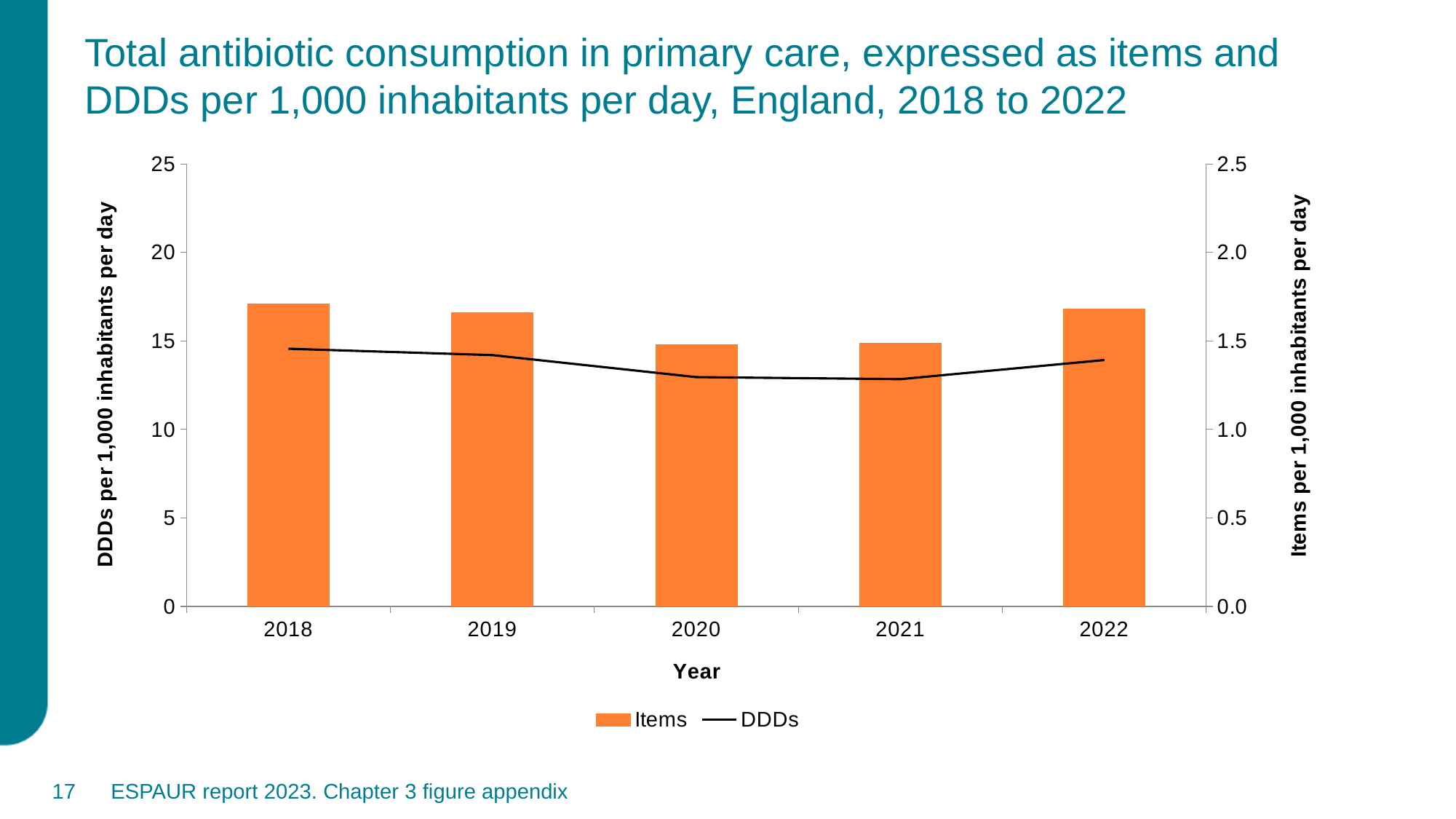
How many years are shown on the x axis of the chart? 5 How many series does the chart legend list? 2 Is the DDDs line value for 2021 greater or less than 10 on the left axis scale? greater Is the Items bar for 2018 greater or less than 15 on the left axis scale? greater What is the title of the x axis of the chart? Year What kind of chart is shown on the slide? Combined bar and line chart Which year has the taller Items bar, 2018 or 2020? 2018 Is the DDDs line value for 2020 greater or less than 15 on the left axis scale? less Does the DDDs line rise or fall from 2018 to 2020? fall Which series is plotted as bars in the chart? Items Which year has the taller Items bar, 2019 or 2021? 2019